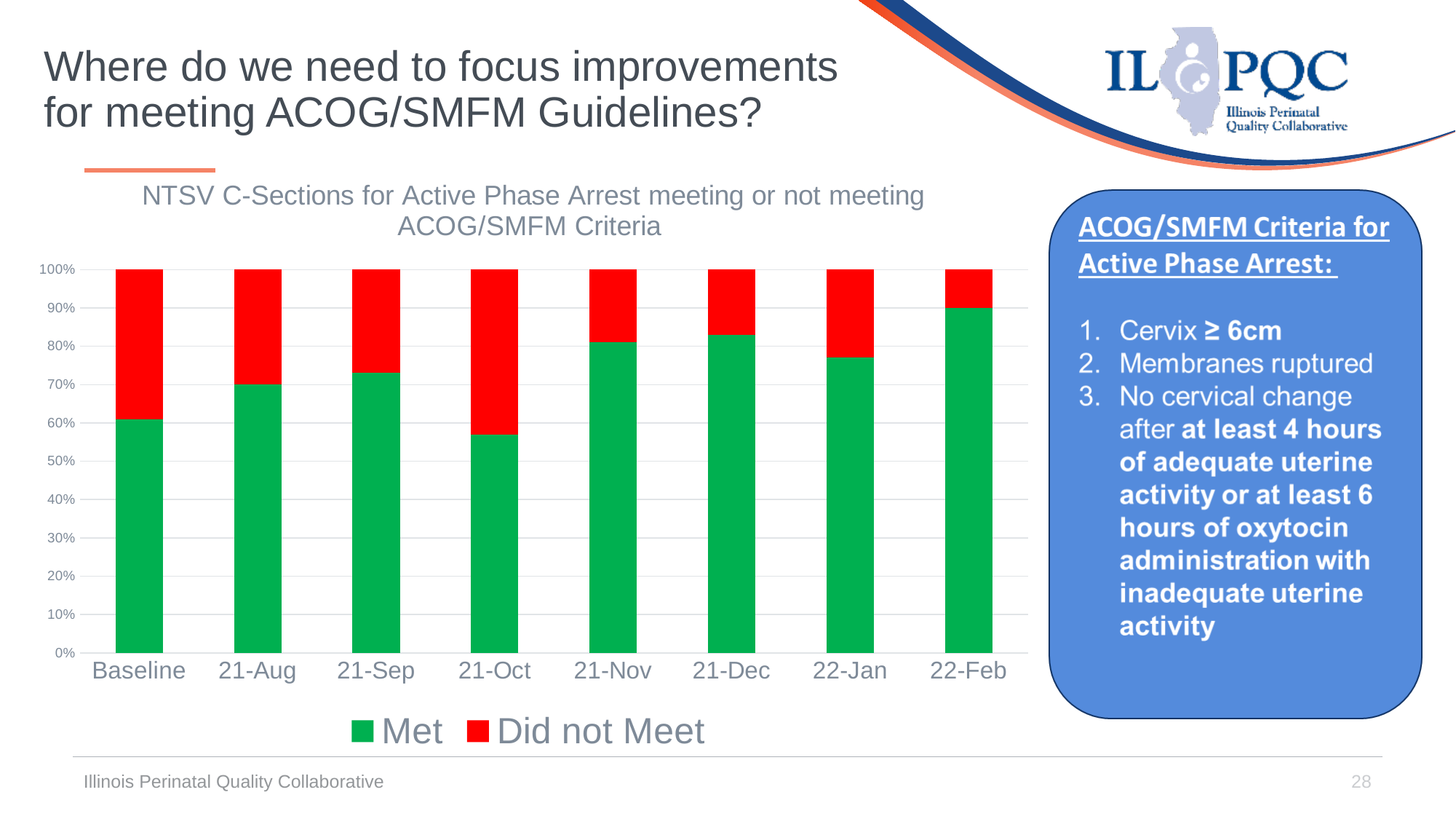
Which category has the largest Did not Meet share? 21-Oct What colour represents the Did not Meet series? red Which category has the lowest Met share? 21-Oct What type of chart is shown on the slide? stacked bar chart Which has a larger Met share, Baseline or 21-Aug? 21-Aug Is the Met value for Baseline greater or less than 70%? less Is the Met value for 21-Dec greater or less than 80%? greater Is the Met value for 21-Oct greater or less than 60%? less How many series does the legend list? 2 How many categories are shown on the x axis? 8 Which category has the highest Met share? 22-Feb